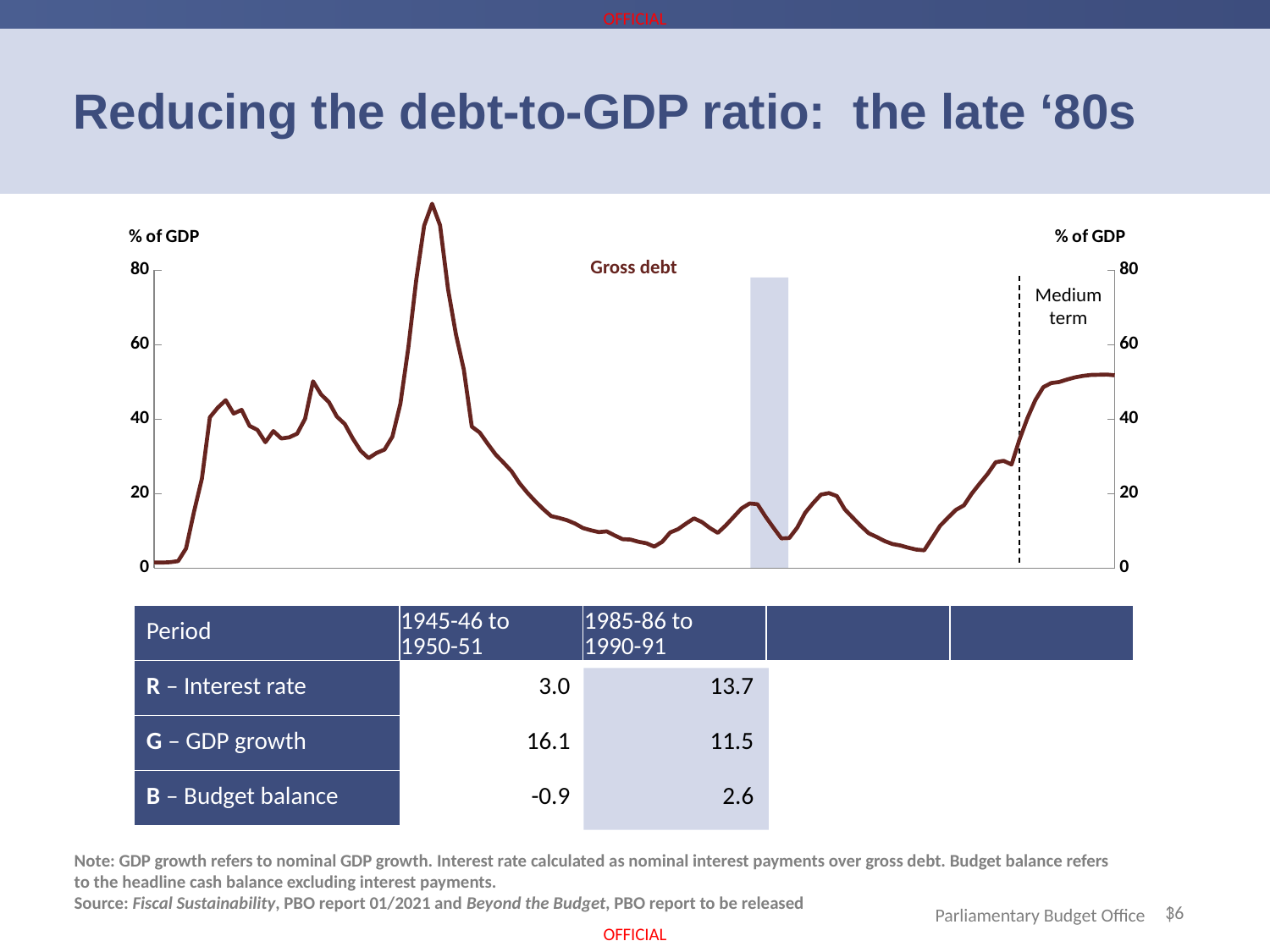
Is the value of the Gross debt line at the right-hand end of the medium term projection greater or less than 60? less Is the peak value of the Gross debt line greater or less than 80? greater Within the shaded band on the chart, is the Gross debt line greater or less than 20? less What is the name of the series plotted on the chart? Gross debt How many data series are plotted on the chart? 1 To the right of the dashed 'Medium term' line, does the Gross debt line rise or fall? rise What kind of chart is shown on the slide? line chart What unit is shown on the vertical axes of the chart? % of GDP From its peak to the shaded band, does the Gross debt line rise or fall overall? fall